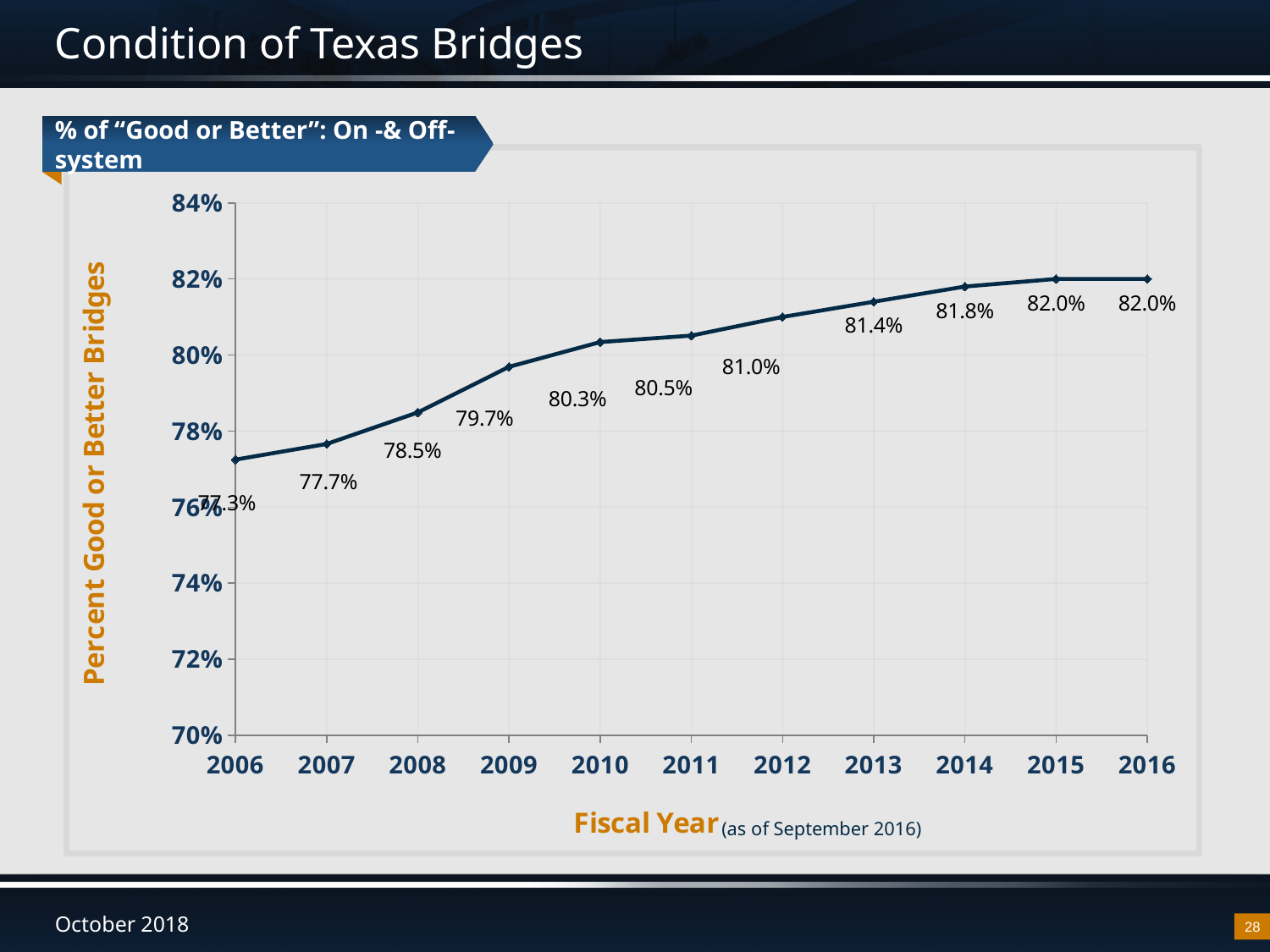
How many fiscal years are plotted on the chart? 11 Which fiscal year has a higher value, 2009 or 2012? 2012 Which fiscal year has the lowest percentage of good or better bridges? 2006 What is the value for fiscal year 2007? 77.7% What is the percentage of good or better bridges in fiscal year 2010? 80.3% What value is shown for fiscal year 2013? 81.4% What is the difference between the values for 2014 and 2008? 3.3% What kind of chart is shown on the slide? line chart What is the value for fiscal year 2016? 82.0% Do the values rise or fall from 2006 to 2016? rise Is the value for fiscal year 2006 greater or less than 78%? less What is the highest value plotted on the chart? 82.0%